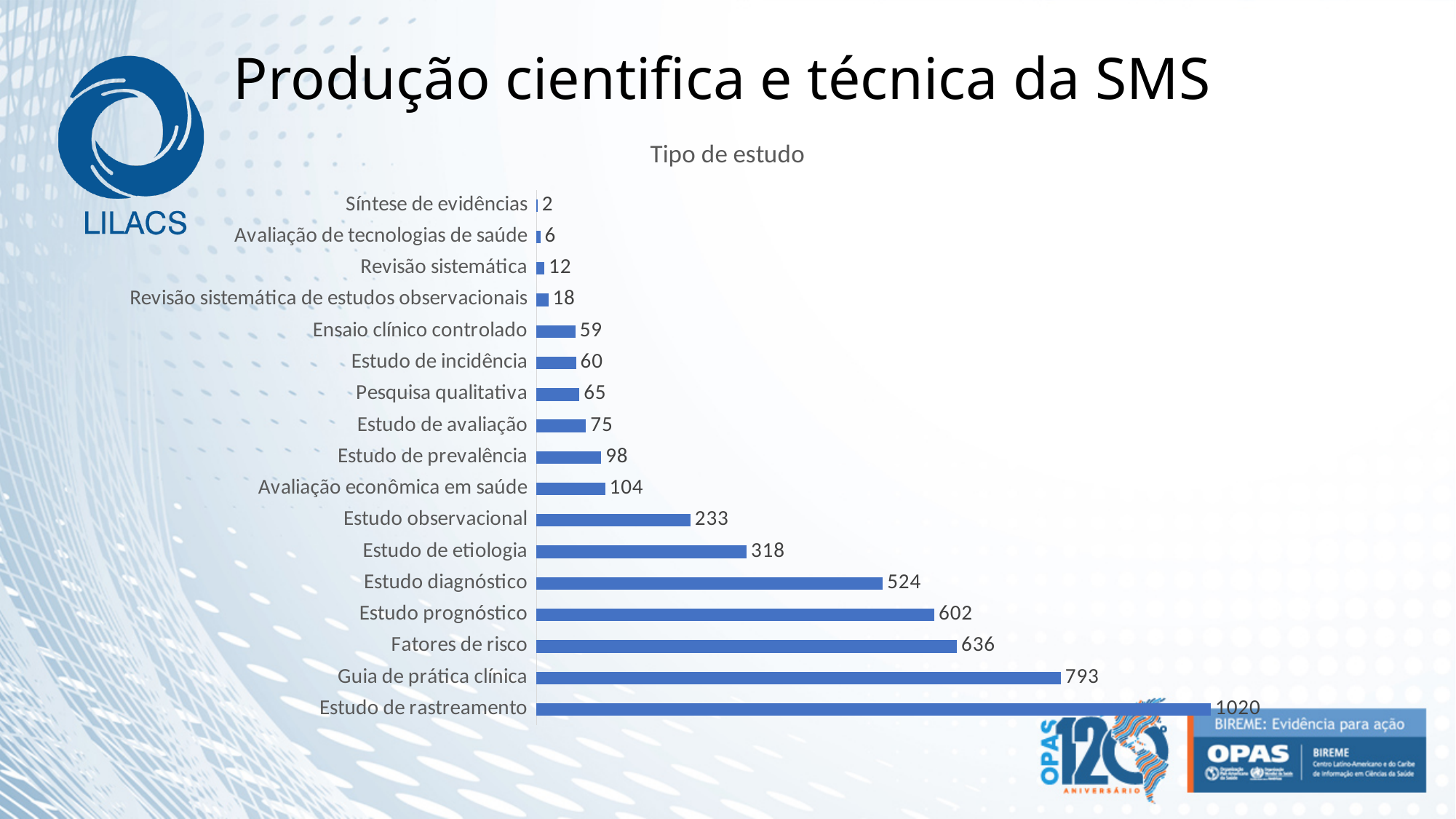
What is the difference between Estudo de rastreamento and Guia de prática clínica? 227 What is the value for Guia de prática clínica? 793 Which study type has the highest value? Estudo de rastreamento How many study types are shown in the chart? 17 Which study type has the lowest value? Síntese de evidências What is the difference between Fatores de risco and Estudo prognóstico? 34 What is the value for Estudo observacional? 233 What is the value for Revisão sistemática? 12 What kind of chart is shown on the slide? Bar chart What is the title of the chart? Tipo de estudo What is the value for Estudo de rastreamento? 1020 Which is larger, Estudo diagnóstico or Estudo de etiologia? Estudo diagnóstico